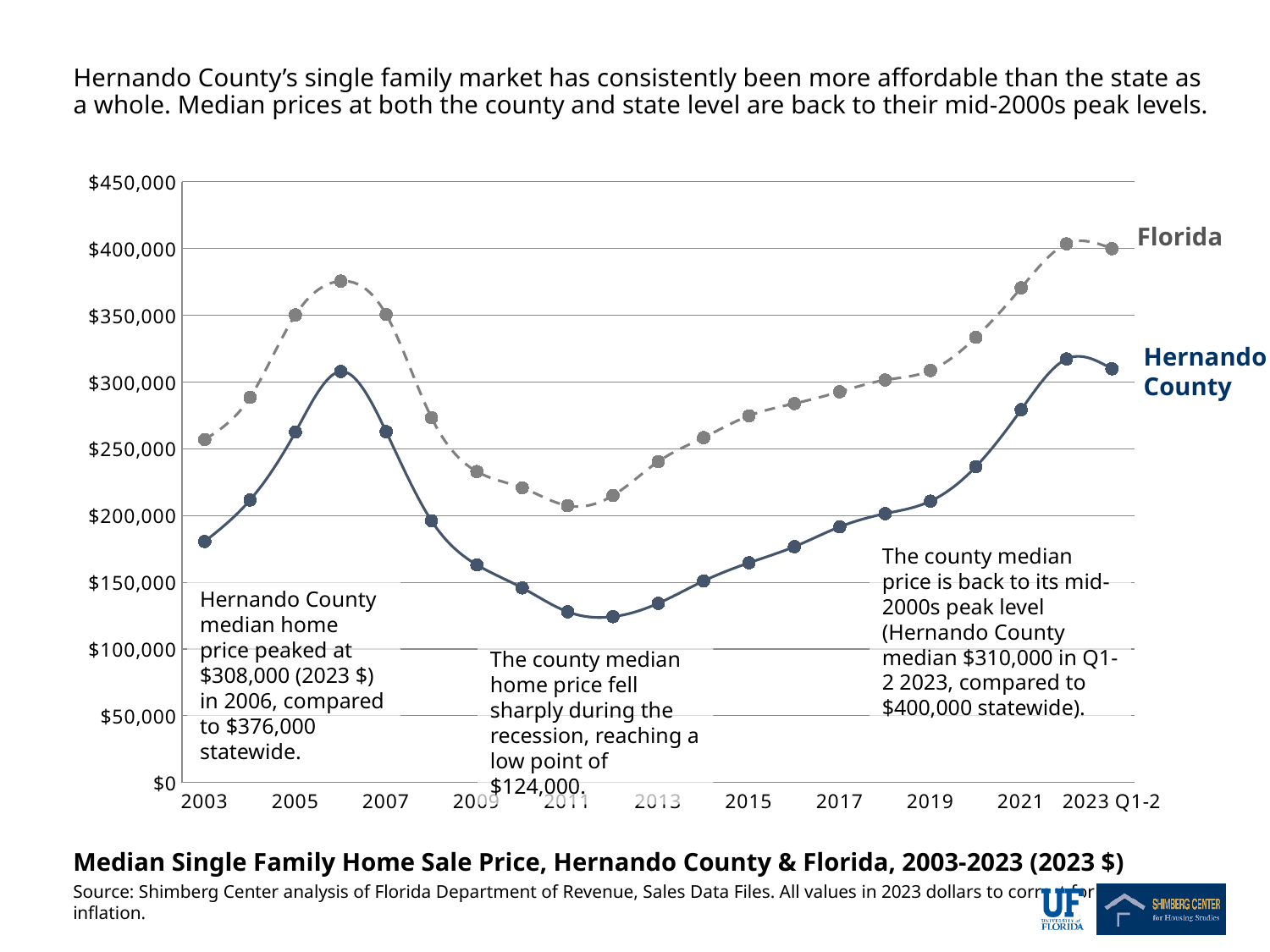
What was Hernando County's peak median home price in 2006, according to the annotation? $308,000 What is the difference between the Florida and Hernando County median prices in Q1-2 2023? $90,000 What is the difference between the statewide and Hernando County median prices in 2006? $68,000 What is the Hernando County median price in Q1-2 2023? $310,000 What type of chart is shown on the slide? Line chart How many series are plotted on the chart? 2 Does the Hernando County median price rise or fall between 2012 and 2022? Rise Is the Hernando County value for 2003 greater or less than $200,000? less Which series is drawn with a dashed line? Florida Which series has the higher median price in 2006, Florida or Hernando County? Florida What low point did the Hernando County median home price reach during the recession? $124,000 What was the statewide median home price in 2006, according to the annotation? $376,000